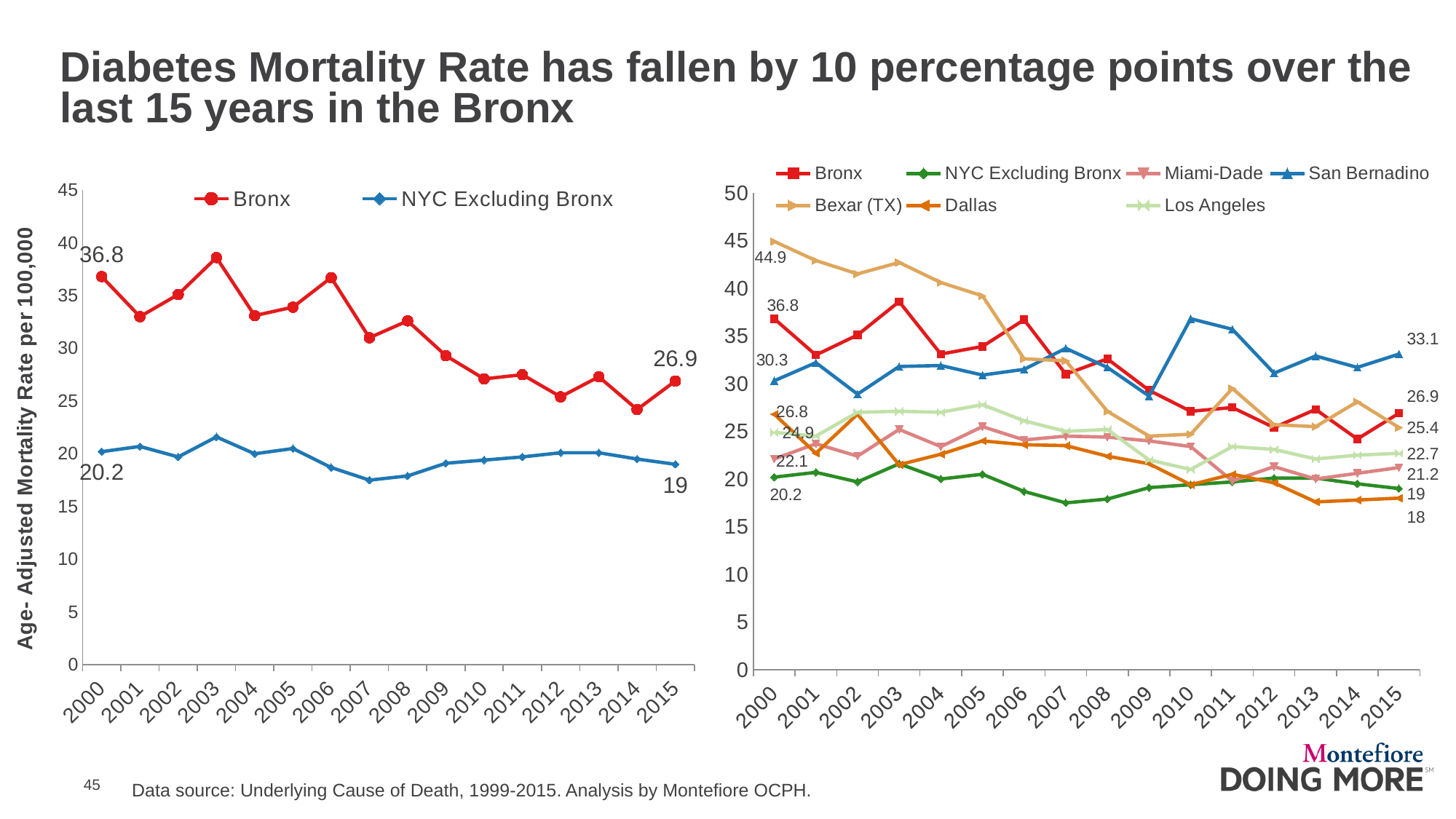
In the right chart, which series had the lowest value in 2015? Dallas In the left chart, by how much did the Bronx rate fall between 2000 and 2015? 9.9 In the left chart, what was the Bronx diabetes mortality rate in 2015? 26.9 In the left chart, how many series does the legend list? 2 In the right chart, which series had the highest value in 2000? Bexar (TX) In the left chart, does the Bronx line generally rise or fall from 2000 to 2015? fall In the right chart, what was the San Bernadino rate in 2015? 33.1 In the right chart, how many series does the legend list? 7 In the right chart, what was the Bexar (TX) rate in 2000? 44.9 In the left chart, what was the Bronx diabetes mortality rate in 2000? 36.8 In the left chart, what was the NYC Excluding Bronx rate in 2015? 19 What type of chart is shown on the left of the slide? line chart